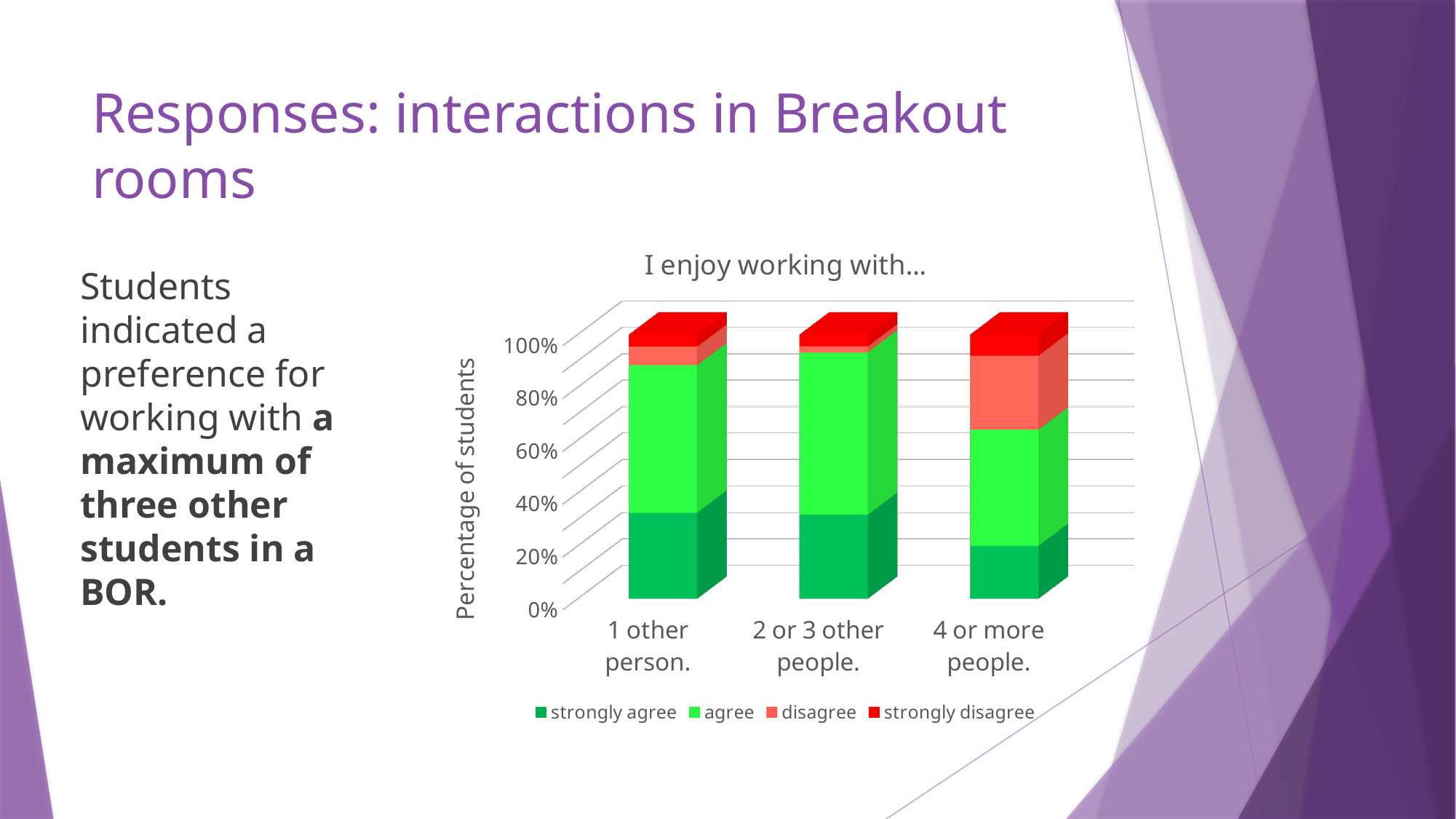
What kind of chart is shown on the slide? stacked bar chart Which category has the smallest 'strongly agree' segment? 4 or more people. Which category has the largest 'strongly disagree' segment? 4 or more people. How many categories are shown on the x axis of the chart? 3 Is the 'agree' segment larger for '2 or 3 other people.' or for '4 or more people.'? 2 or 3 other people. Is the 'strongly agree' share for '1 other person.' greater or less than 20%? greater What is the title of the chart? I enjoy working with… Is the 'strongly disagree' segment larger for '4 or more people.' or for '1 other person.'? 4 or more people. What is the label of the vertical axis? Percentage of students Is the 'strongly agree' share for '4 or more people.' greater or less than 40%? less Which category has the largest 'disagree' segment? 4 or more people. How many series does the chart's legend list? 4